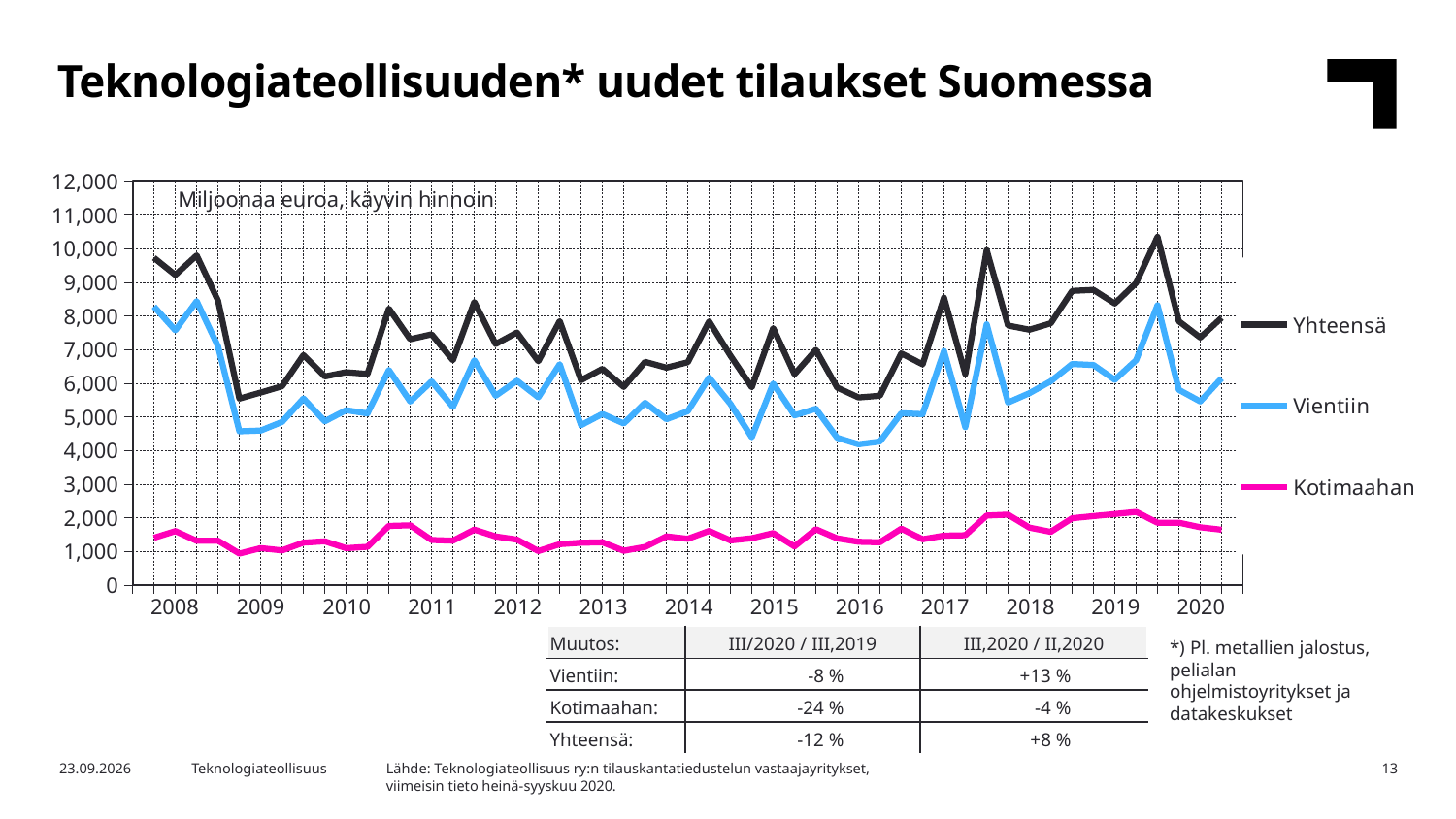
Is the peak value of Yhteensä in 2019 greater or less than 10,000? greater Does the Yhteensä line rise or fall from the start of 2008 to the start of 2009? fall Is the value for Kotimaahan at the start of 2008 greater or less than 3,000? less Which series is larger in 2018, Vientiin or Kotimaahan? Vientiin How many years are labelled on the x axis? 13 What kind of chart is shown on the slide? line chart What is the title of the chart on the slide? Teknologiateollisuuden* uudet tilaukset Suomessa Which series has the lowest values throughout the chart? Kotimaahan How many series does the legend list? 3 What are the three series named in the legend? Yhteensä, Vientiin, Kotimaahan Which series has the highest values throughout the chart? Yhteensä Is the lowest value for Vientiin in 2016 greater or less than 5,000? less